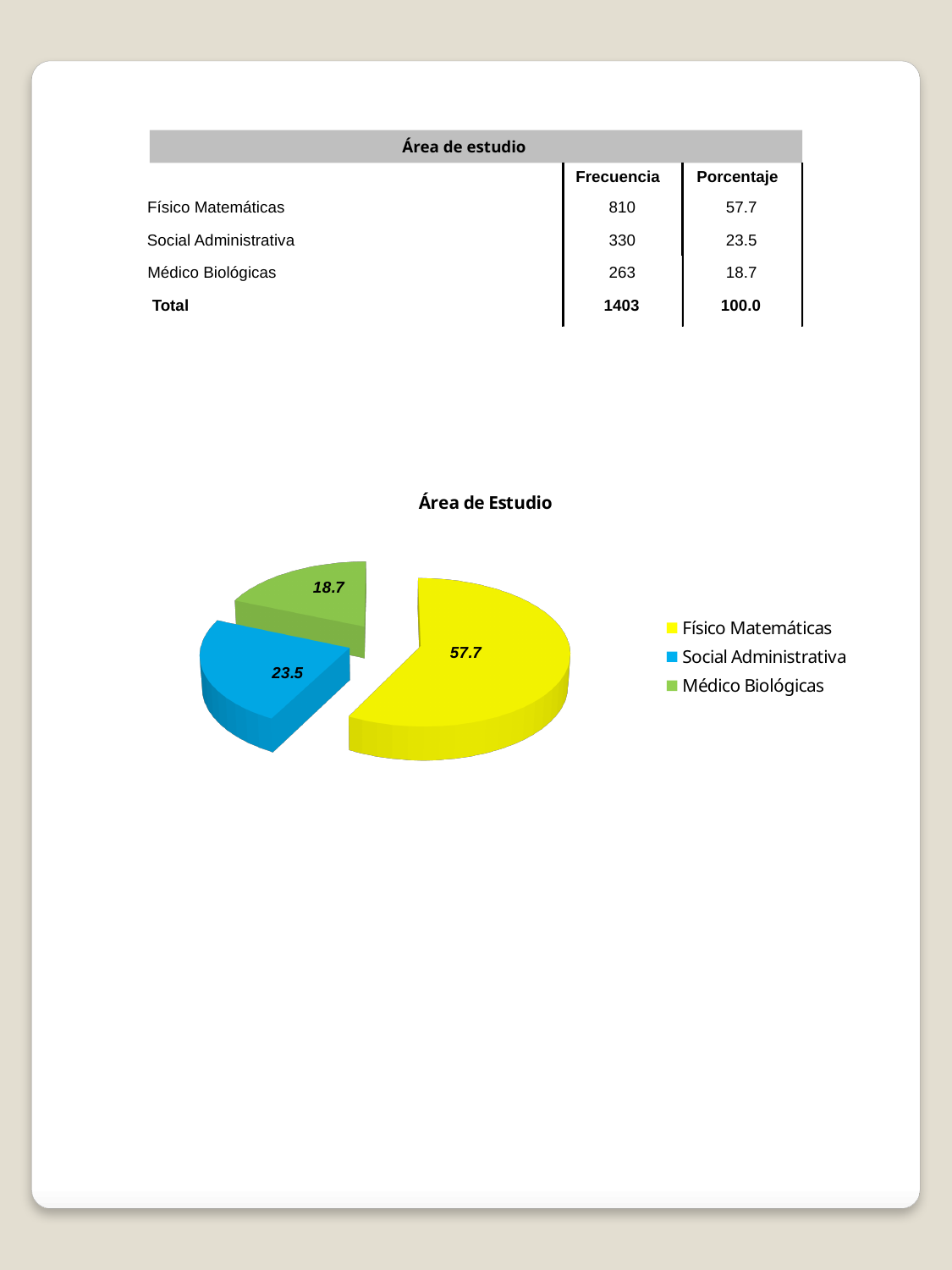
Which colour represents Social Administrativa in the legend? blue What is the difference between the values for Social Administrativa and Médico Biológicas? 4.8 What is the title of the chart? Área de Estudio What value is shown for the Médico Biológicas slice? 18.7 What type of chart is shown on the slide? pie chart What is the difference between the values for Físico Matemáticas and Social Administrativa? 34.2 Which category has the smallest slice of the pie? Médico Biológicas What value is shown for the Físico Matemáticas slice? 57.7 What value is shown for the Social Administrativa slice? 23.5 Which category has the largest slice of the pie? Físico Matemáticas How many slices does the pie chart have? 3 Which is larger, the slice for Social Administrativa or the slice for Médico Biológicas? Social Administrativa